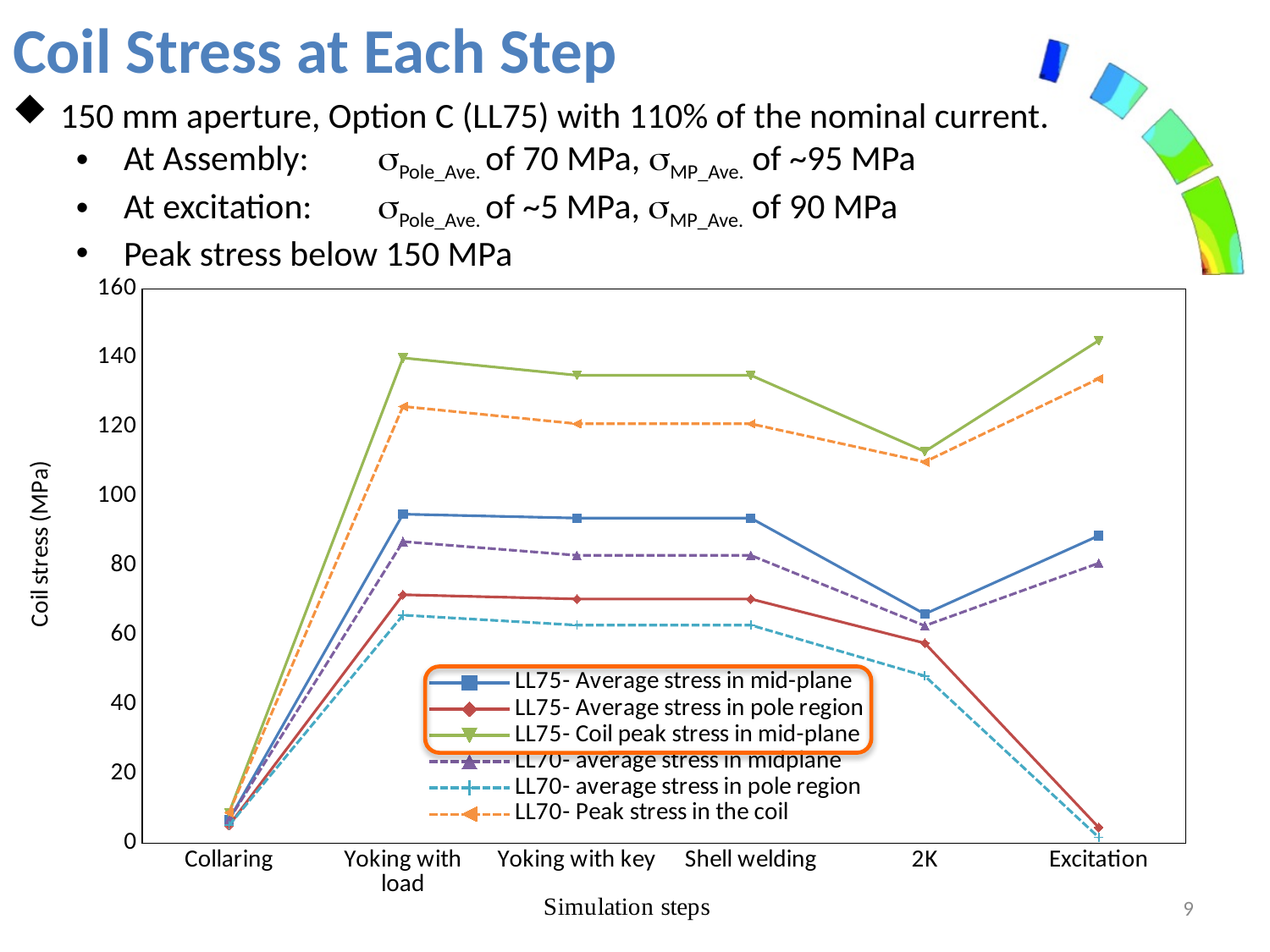
Which series has the highest value at the Excitation step? LL75- Coil peak stress in mid-plane Does 'LL75- Average stress in pole region' rise or fall from Shell welding to Excitation? fall What is the title of the chart's horizontal axis? Simulation steps How many series does the chart's legend list? 6 What is the title of the chart's vertical axis? Coil stress (MPa) Is the value of 'LL70- Peak stress in the coil' at Yoking with load greater or less than 120? greater What kind of chart is shown on the slide? line chart Is the value of 'LL75- Coil peak stress in mid-plane' at 2K greater or less than 120? less How many simulation steps are shown along the x axis of the chart? 6 Is the value of 'LL75- Average stress in pole region' at Excitation greater or less than 20? less At which simulation step is 'LL75- Coil peak stress in mid-plane' lowest? Collaring